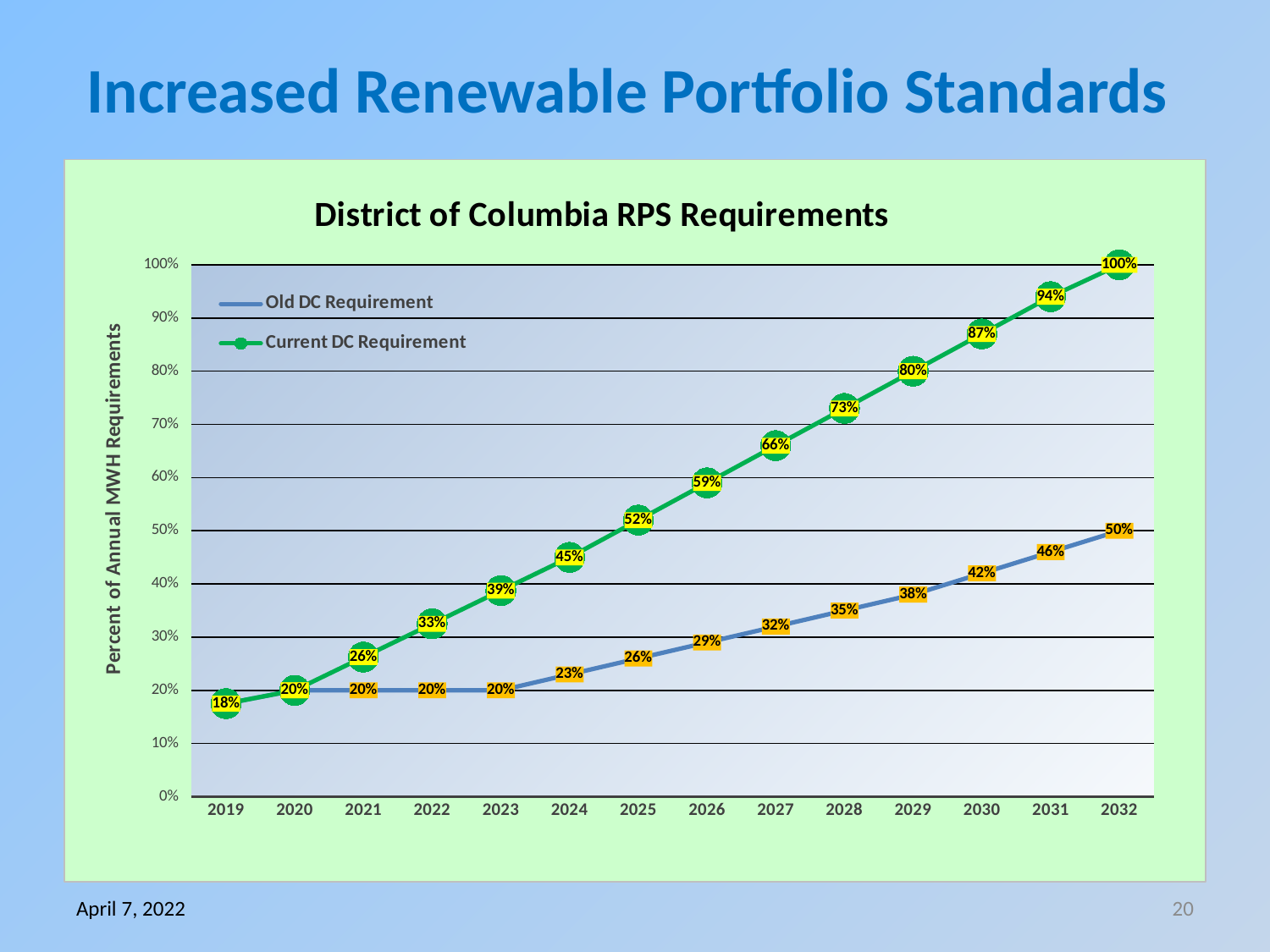
What type of chart is shown on the slide? line chart What is the title of the chart? District of Columbia RPS Requirements What is the difference between the Old DC Requirement in 2032 and in 2023? 30% What is the Old DC Requirement value for 2030? 42% What is the difference between the Current DC Requirement and the Old DC Requirement in 2032? 50% How many years are shown on the x axis? 14 What is the Current DC Requirement value for 2019? 18% Which is larger in 2027, the Current DC Requirement or the Old DC Requirement? Current DC Requirement How many series does the legend list? 2 Does the Current DC Requirement rise or fall from 2019 to 2032? rise In which year does the Current DC Requirement reach its highest value? 2032 What is the Current DC Requirement value for 2025? 52%